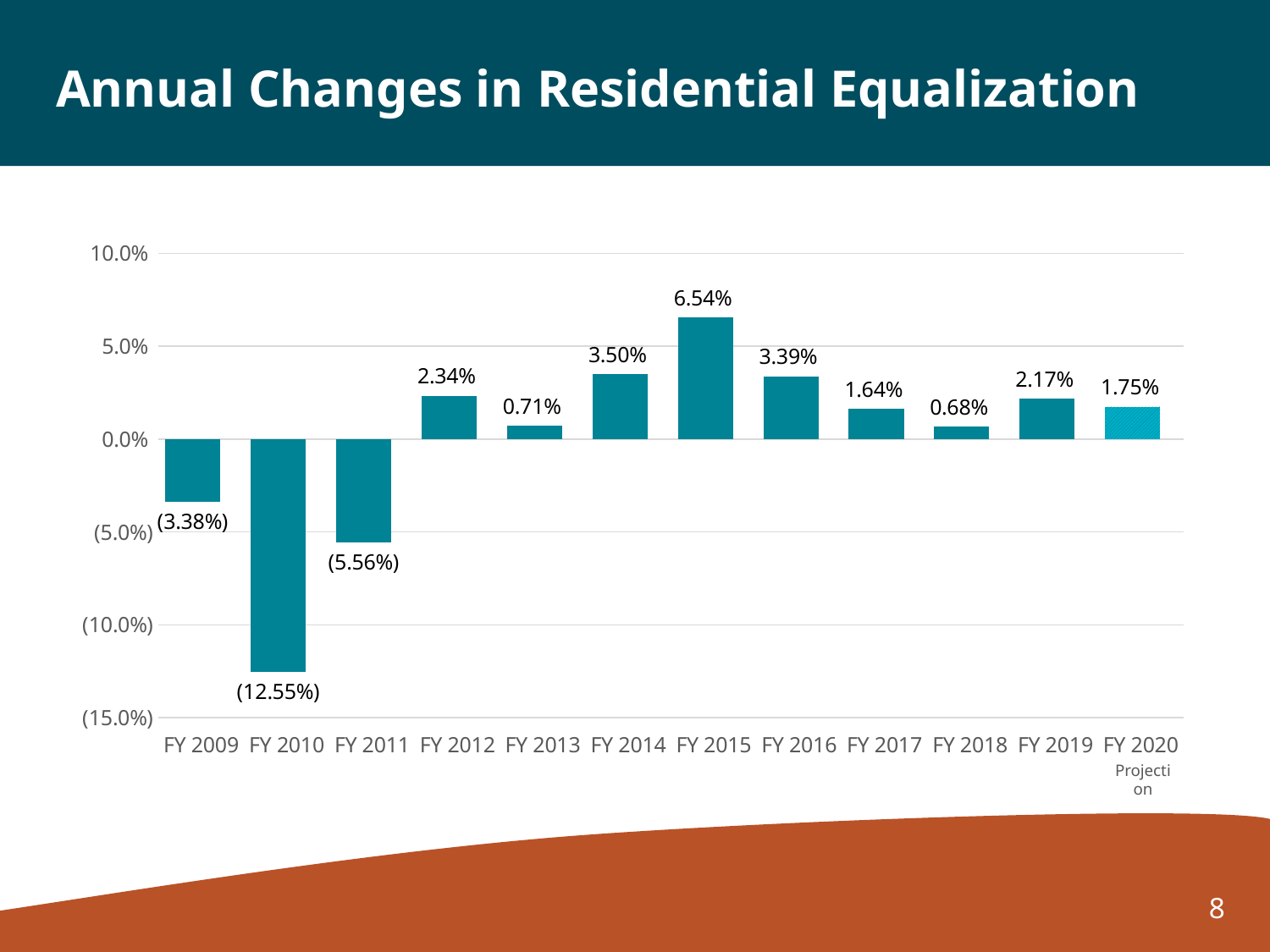
Which fiscal year has the highest value? FY 2015 What is the value for FY 2015? 6.54% What is the value for FY 2020 Projection? 1.75% What is the value for FY 2010? (12.55%) What is the title of the chart? Annual Changes in Residential Equalization Which fiscal year has the lowest value? FY 2010 How many fiscal years are shown on the x axis? 12 Do the values rise or fall from FY 2016 to FY 2018? fall Which is larger, the value for FY 2012 or the value for FY 2019? FY 2012 What is the difference between the values for FY 2015 and FY 2014? 3.04% Is the value for FY 2011 greater or less than (5.0%)? less What kind of chart is shown? bar chart